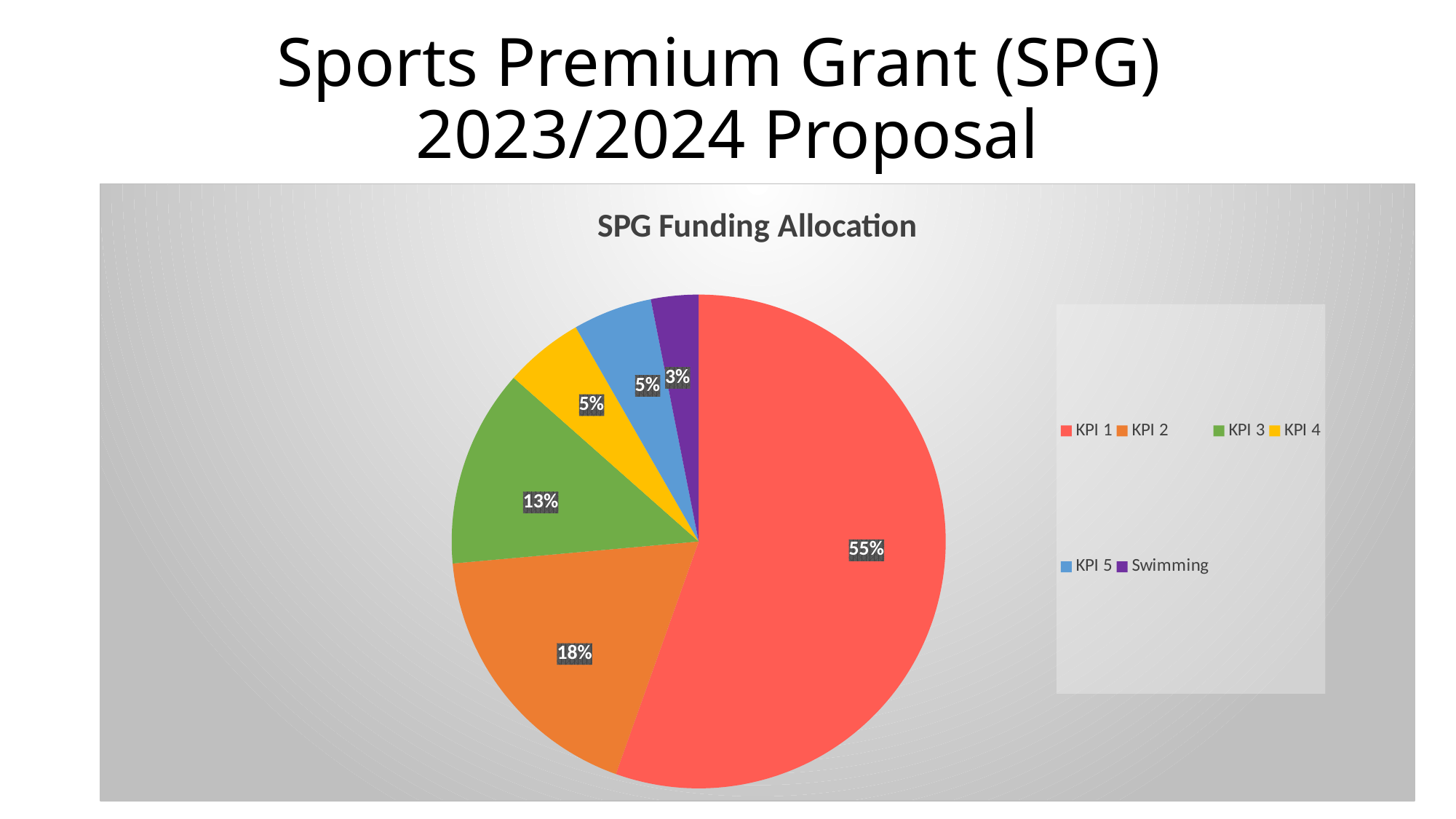
What share of the pie does Swimming take? 3% Which category has the largest slice of the pie? KPI 1 What is the difference between the shares of KPI 1 and KPI 2? 37% What colour is the KPI 1 slice? red Which category has the smallest slice of the pie? Swimming What is the title of the chart? SPG Funding Allocation What share of the pie does KPI 3 take? 13% How many slices does the pie chart have? 6 What share of the pie does KPI 2 take? 18% What kind of chart is shown on the slide? pie chart Which is larger, the share for KPI 3 or the share for KPI 4? KPI 3